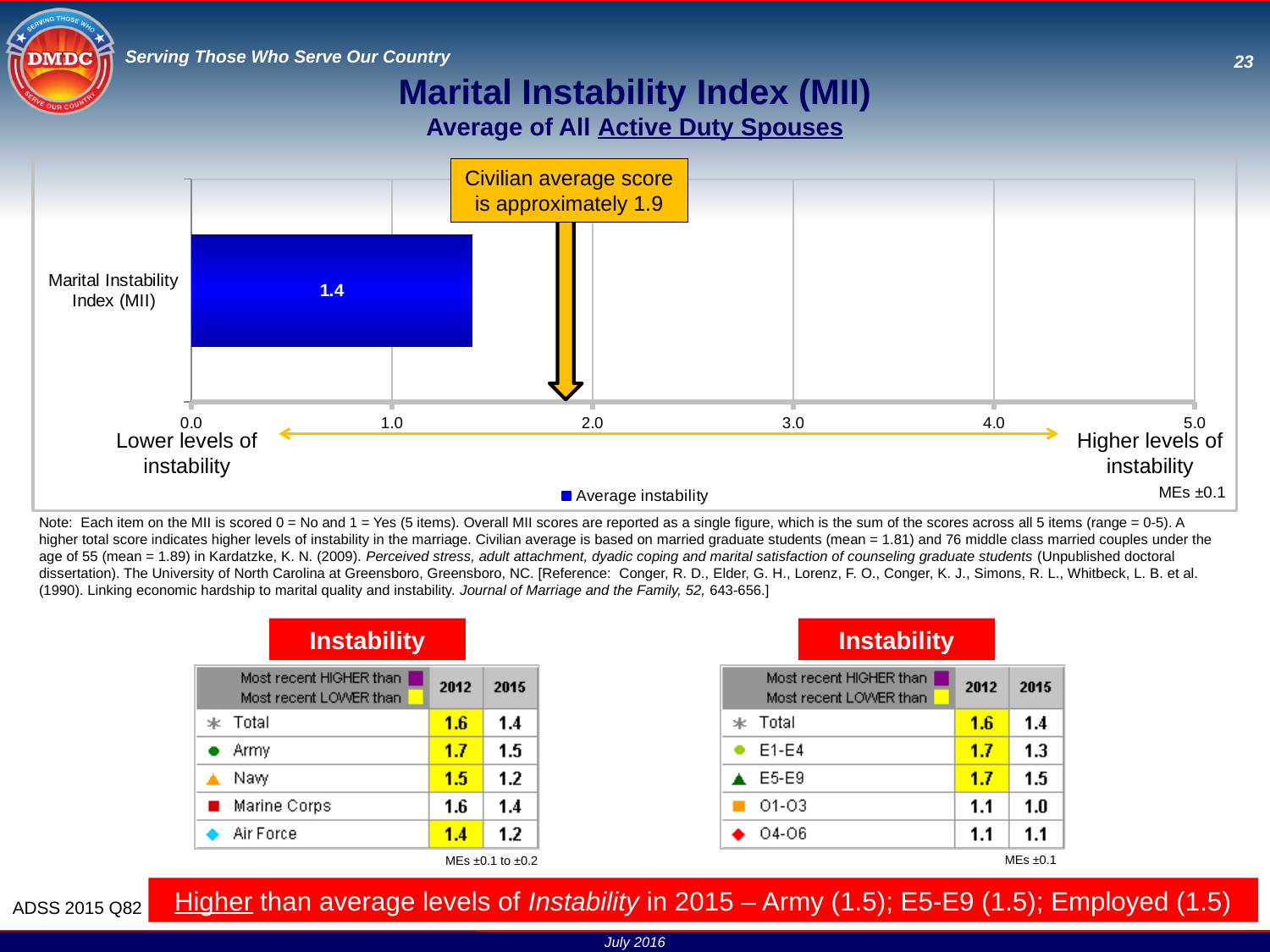
How many series does the chart legend list? 1 Is the value of the Marital Instability Index (MII) bar greater or less than 1.0? greater Is the value of the Marital Instability Index (MII) bar greater or less than 2.0? less According to the callout on the chart, what is the approximate civilian average score? approximately 1.9 Which is larger: the plotted MII bar value or the civilian average score shown in the callout? the civilian average score What is the maximum value shown on the chart's x axis? 5.0 What kind of chart is shown on the slide? bar chart What is the legend entry for the bar in the chart? Average instability What is the value of the Marital Instability Index (MII) bar in the chart? 1.4 How many bars are plotted in the chart? 1